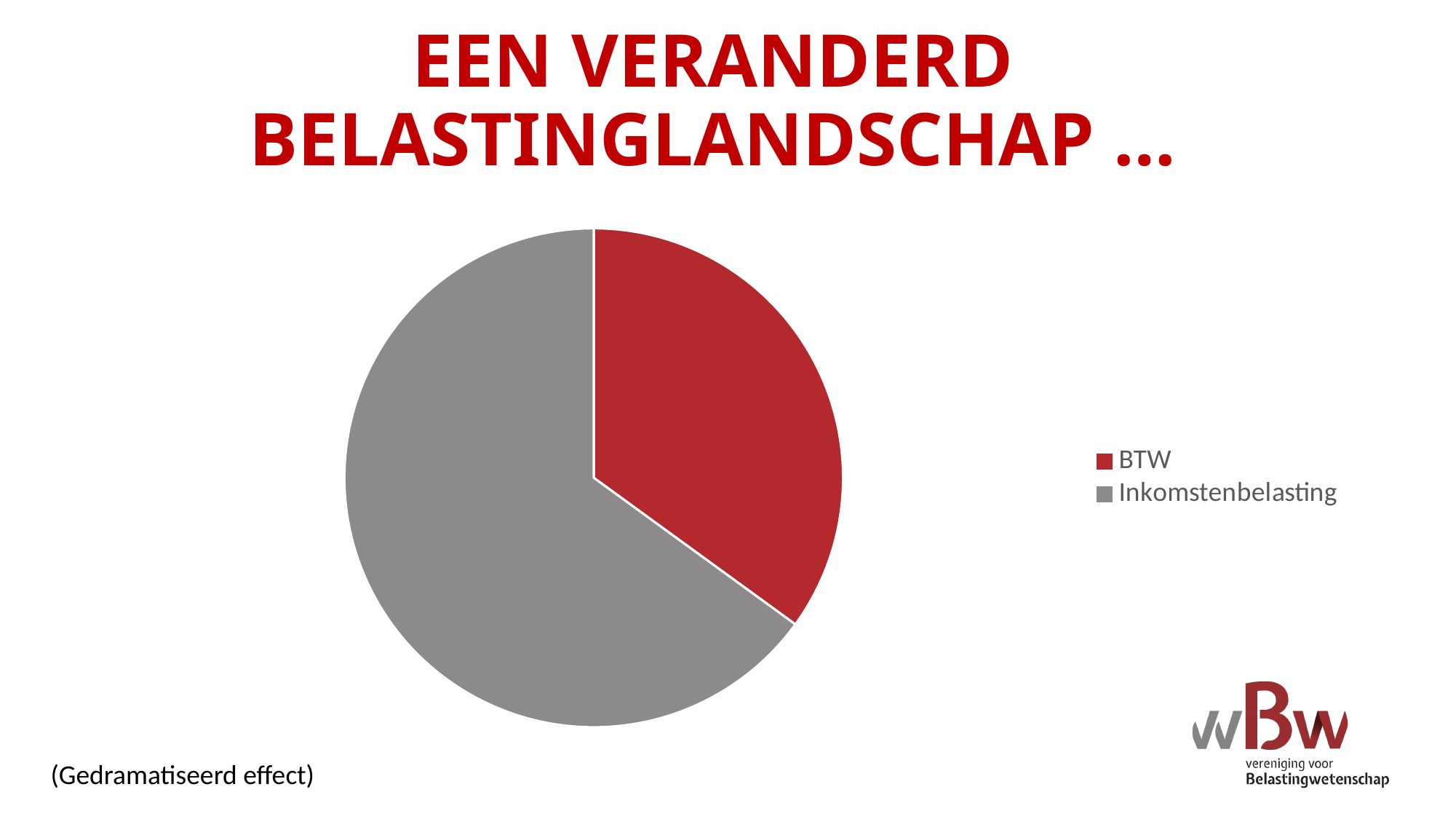
How many entries does the legend of the pie chart list? 2 Which slice is larger, BTW or Inkomstenbelasting? Inkomstenbelasting Which category has the largest slice of the pie chart? Inkomstenbelasting How many slices does the pie chart have? 2 What colour is the BTW slice in the pie chart? red Which category has the smallest slice of the pie chart? BTW What kind of chart is shown on the slide? pie chart What colour is the Inkomstenbelasting slice in the pie chart? grey